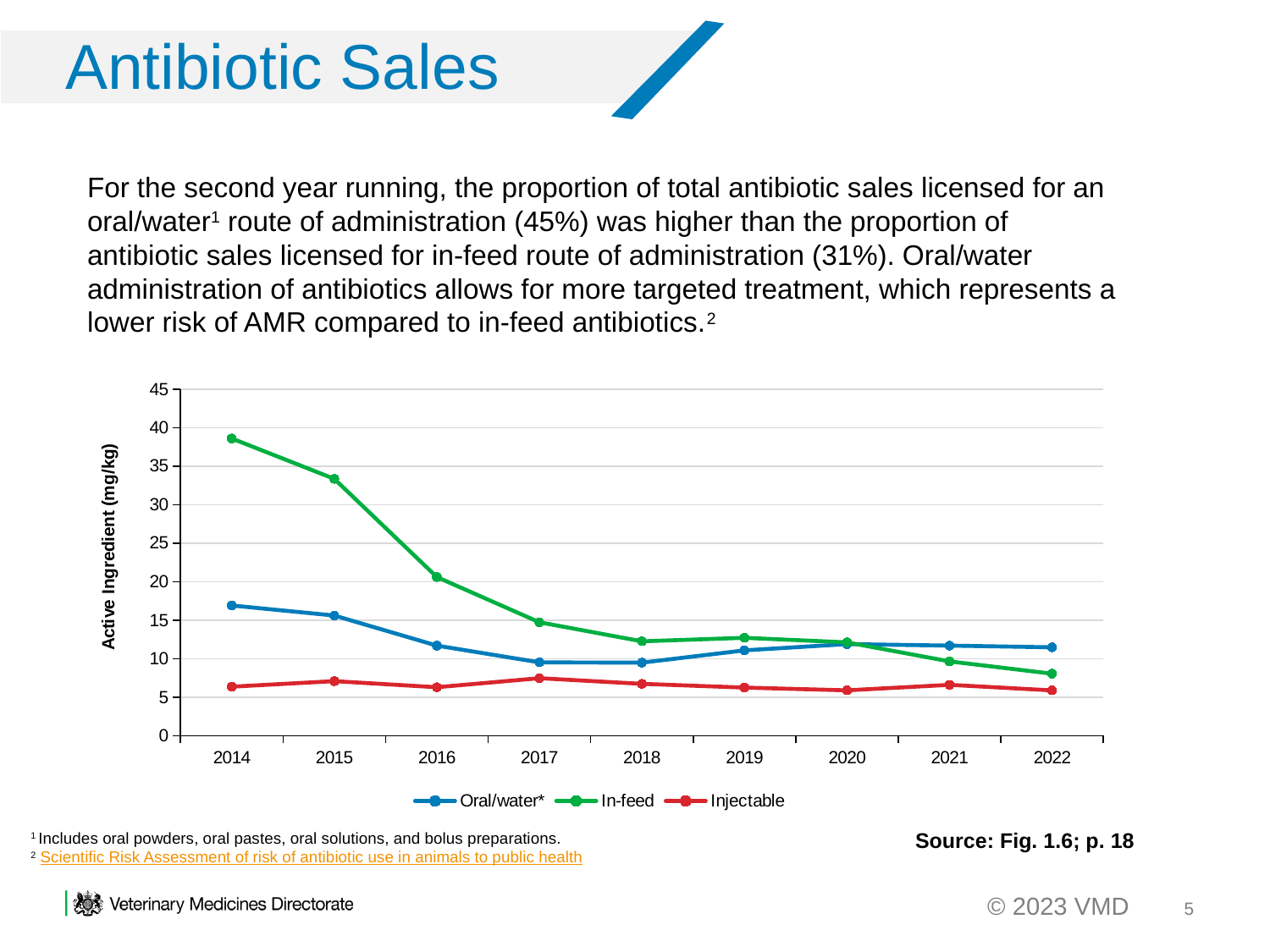
Which series has the lowest value in 2014? Injectable How many years are plotted along the x axis of the chart? 9 In which year is the In-feed series at its highest? 2014 What kind of chart is shown on the slide? line chart Is the In-feed value for 2014 greater or less than 35? greater Does the In-feed series rise or fall from 2014 to 2022? fall Is the Injectable value for 2022 greater or less than 10? less How many series does the chart's legend list? 3 In 2022, which series has the higher value: Oral/water* or In-feed? Oral/water* Is the Oral/water* value for 2014 greater or less than 15? greater In 2014, which series has the higher value: In-feed or Oral/water*? In-feed